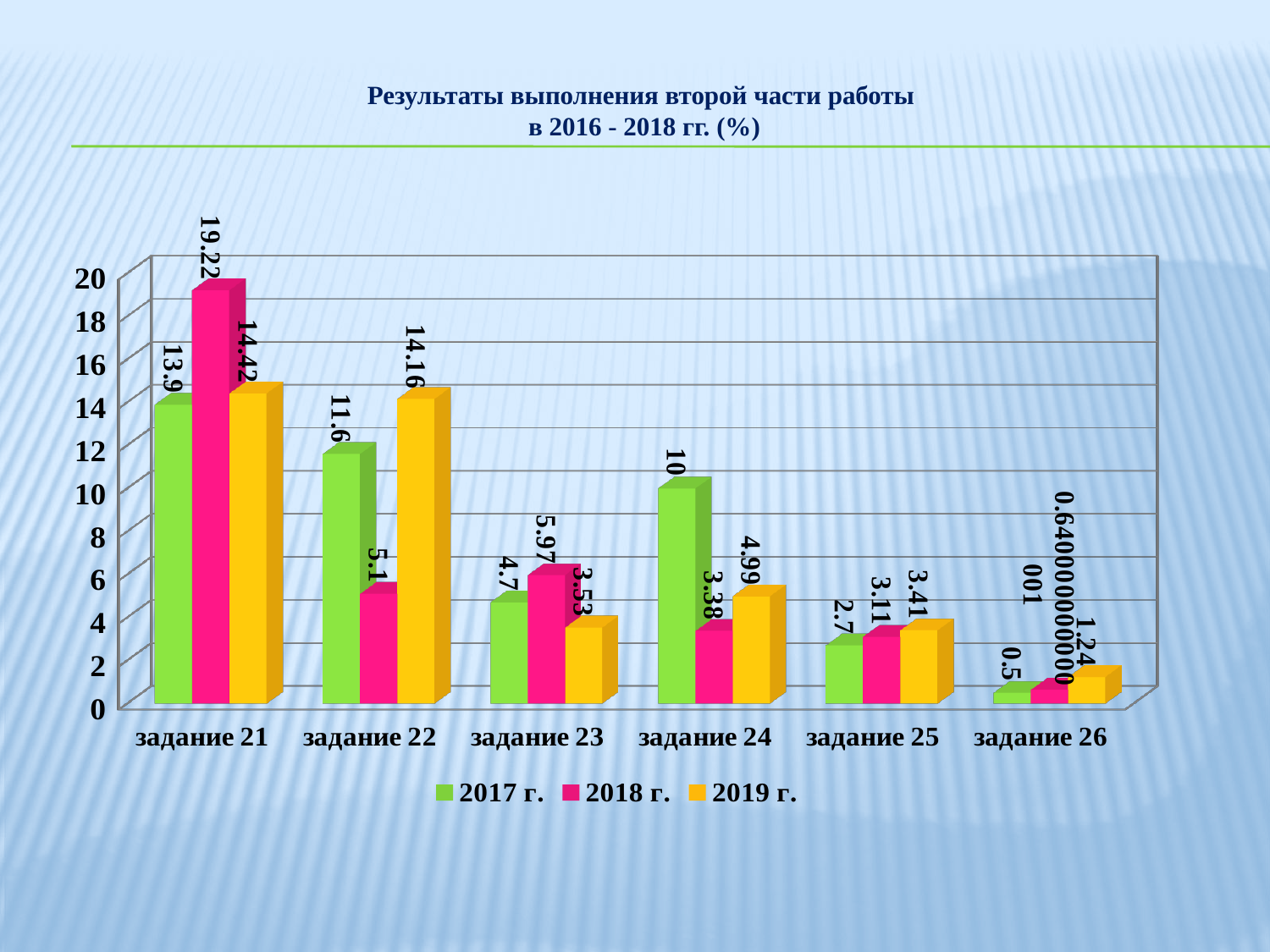
What kind of chart is shown on the slide? bar chart What is the value for задание 22 in the 2019 г. series? 14.16 What is the difference between the 2018 г. and 2017 г. values for задание 21? 5.32 How many categories are shown on the x axis? 6 What is the value for задание 24 in the 2017 г. series? 10 Which category has the lowest value in the 2017 г. series? задание 26 Which is larger for задание 22: the 2017 г. value or the 2019 г. value? 2019 г. Which category has the highest value in the 2018 г. series? задание 21 What is the value for задание 25 in the 2018 г. series? 3.11 What is the value for задание 21 in the 2018 г. series? 19.22 What is the title of the chart? Результаты выполнения второй части работы в 2016 - 2018 гг. (%) How many series does the legend list? 3